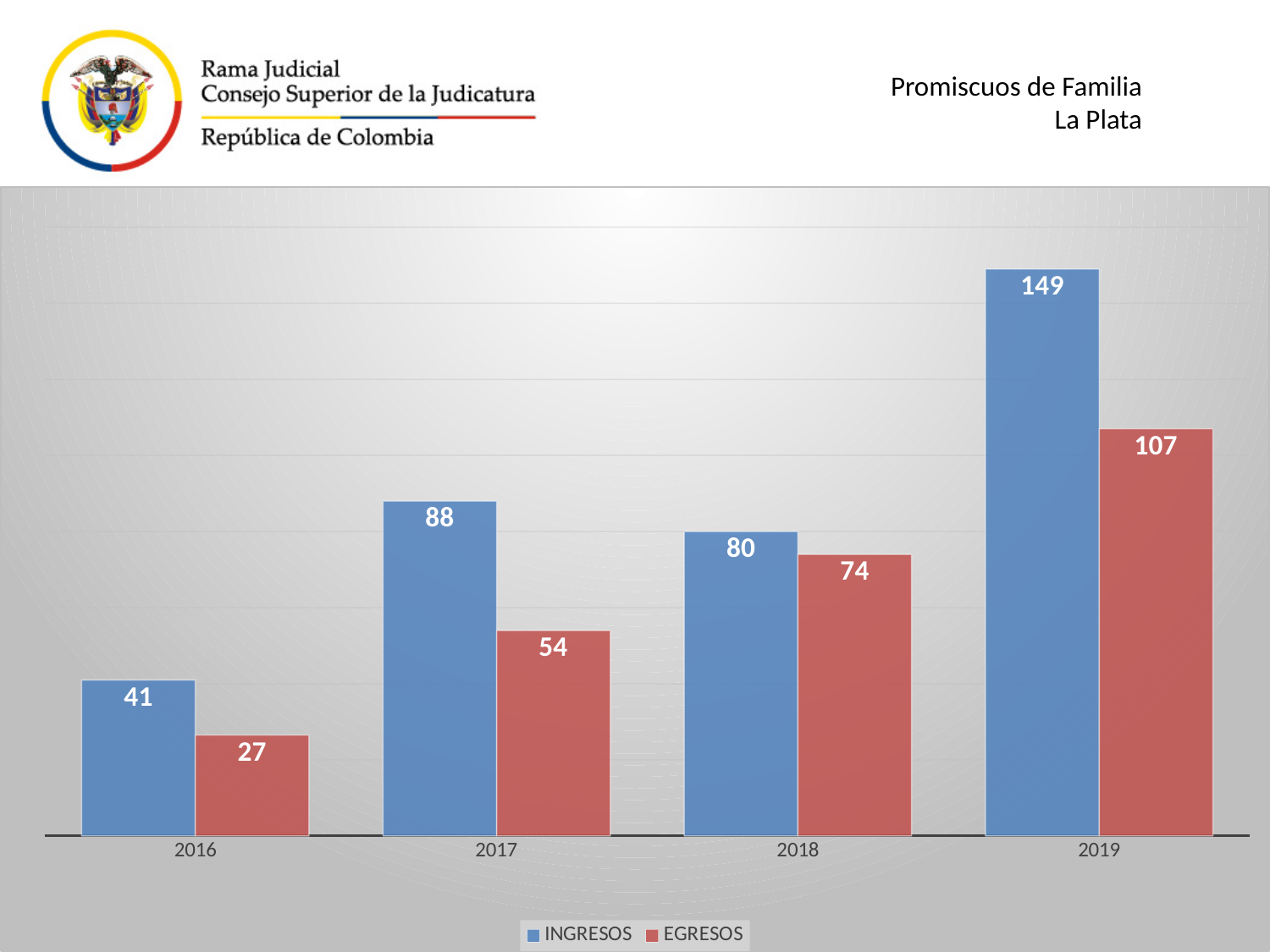
Which year has the lowest EGRESOS value? 2016 What is the EGRESOS value for 2017? 54 Which is larger, INGRESOS in 2018 or EGRESOS in 2019? EGRESOS in 2019 How many years are shown on the x axis? 4 What kind of chart is shown on the slide? Bar chart Which colour represents the EGRESOS series? Red How many series does the legend list? 2 What is the difference between INGRESOS and EGRESOS in 2019? 42 Which year has the highest INGRESOS value? 2019 What is the difference between INGRESOS in 2017 and INGRESOS in 2018? 8 What is the INGRESOS value for 2019? 149 What is the EGRESOS value for 2016? 27